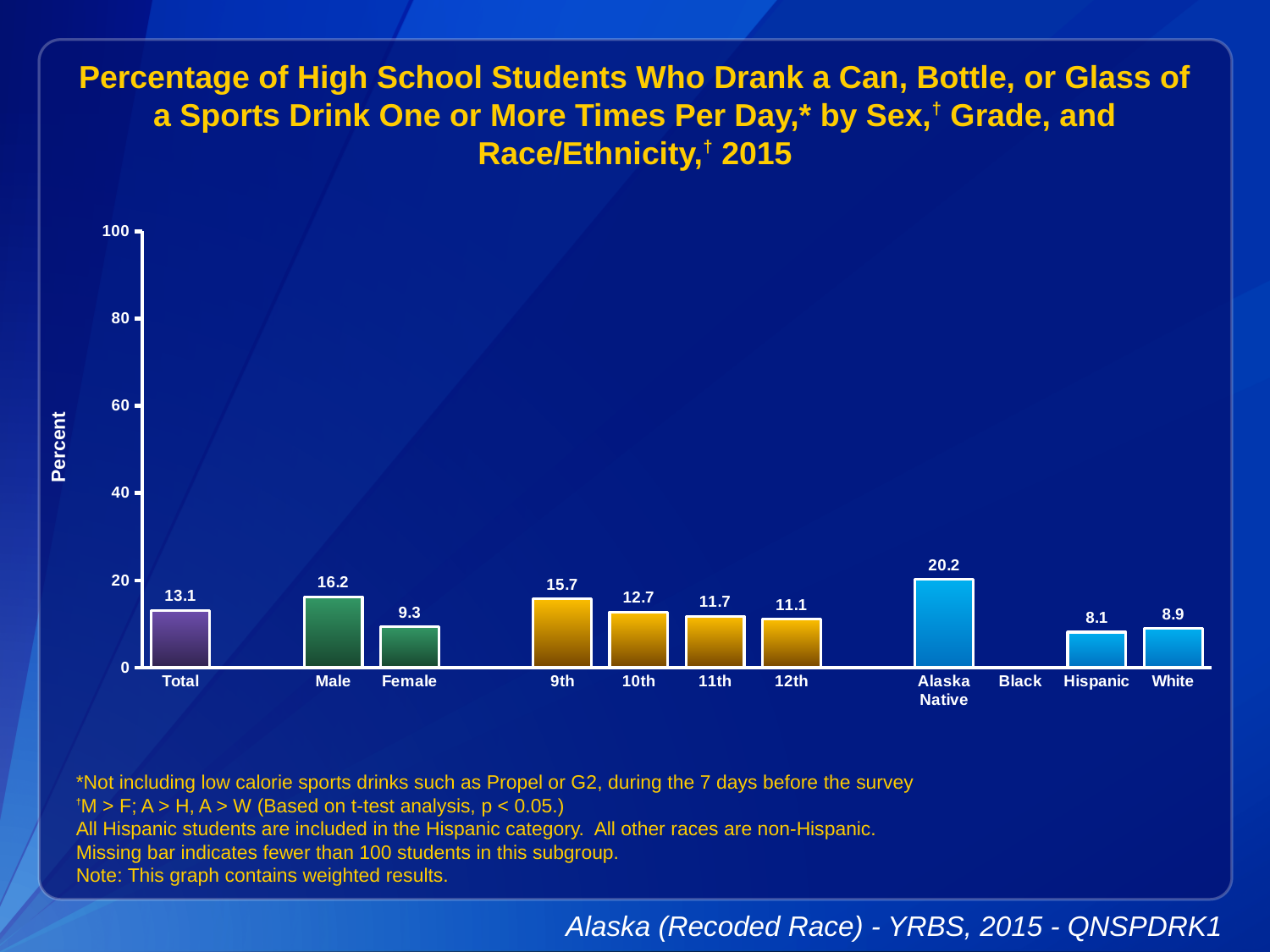
How many categories are labeled on the x axis? 11 What is the value for Total? 13.1 What is the value for Male? 16.2 What kind of chart is shown? bar chart Do the values rise or fall from 9th grade to 12th grade? fall Which category has the highest value? Alaska Native Is the value for Alaska Native greater or less than 20? greater What is the difference between the Male and Female values? 6.9 Which category with a plotted bar has the lowest value? Hispanic What is the value for Alaska Native? 20.2 Which category has no bar plotted? Black Which is larger, the value for 9th grade or the value for 12th grade? 9th